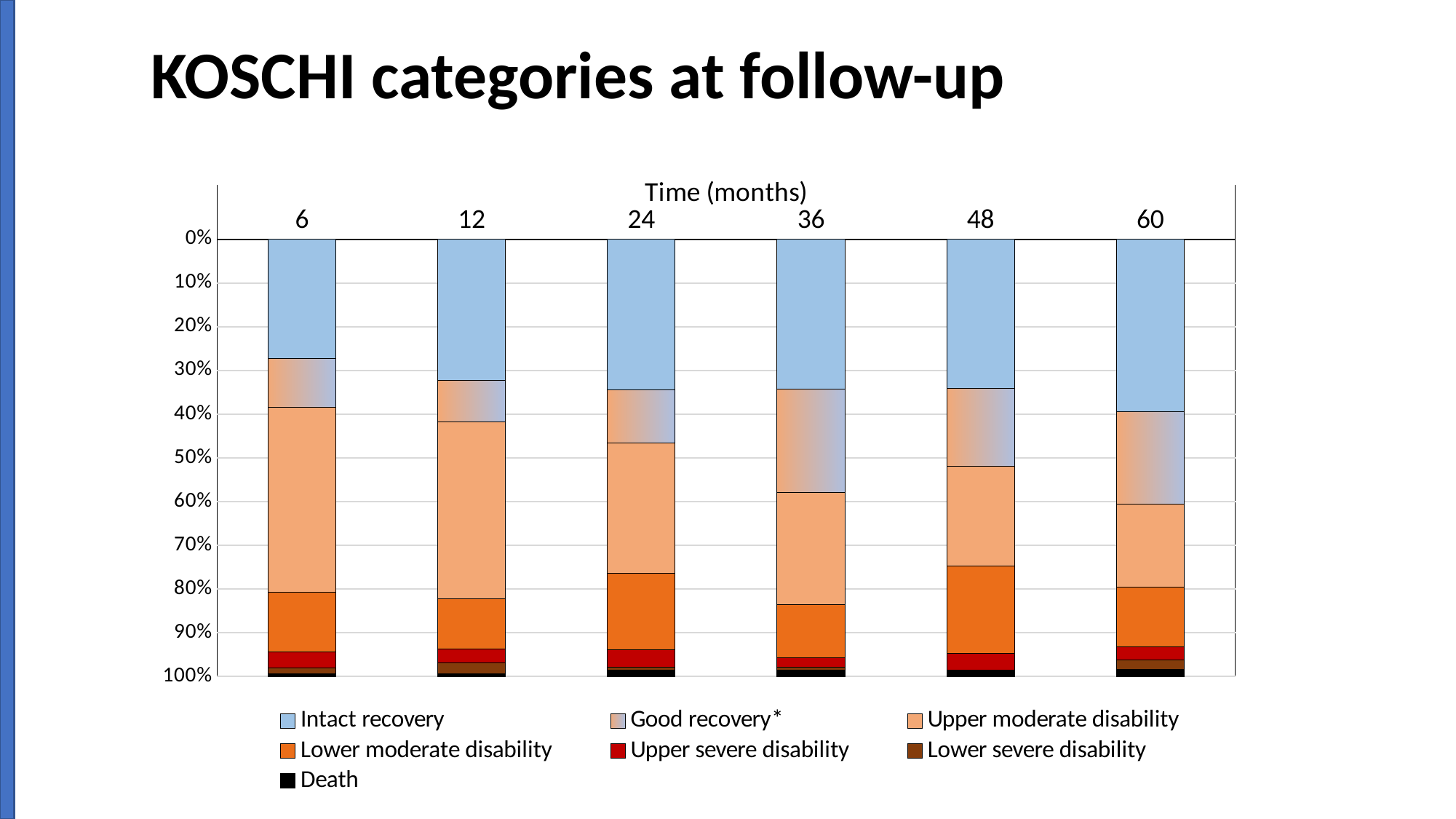
Which time point has the largest Intact recovery share? 60 Is the Intact recovery share larger at 6 months or at 48 months? 48 months How many series does the legend list? 7 How many time points are plotted along the x axis? 6 Which time point has the largest Good recovery share? 36 What kind of chart is shown on the slide? Stacked bar chart Is the Good recovery share at 36 months greater or less than 20%? greater Is the Intact recovery share at 6 months greater or less than 30%? less Is the Upper moderate disability share at 6 months greater or less than 40%? greater Which time point has the smallest Intact recovery share? 6 Which legend entry is marked with an asterisk? Good recovery* What is the title of the x axis? Time (months)